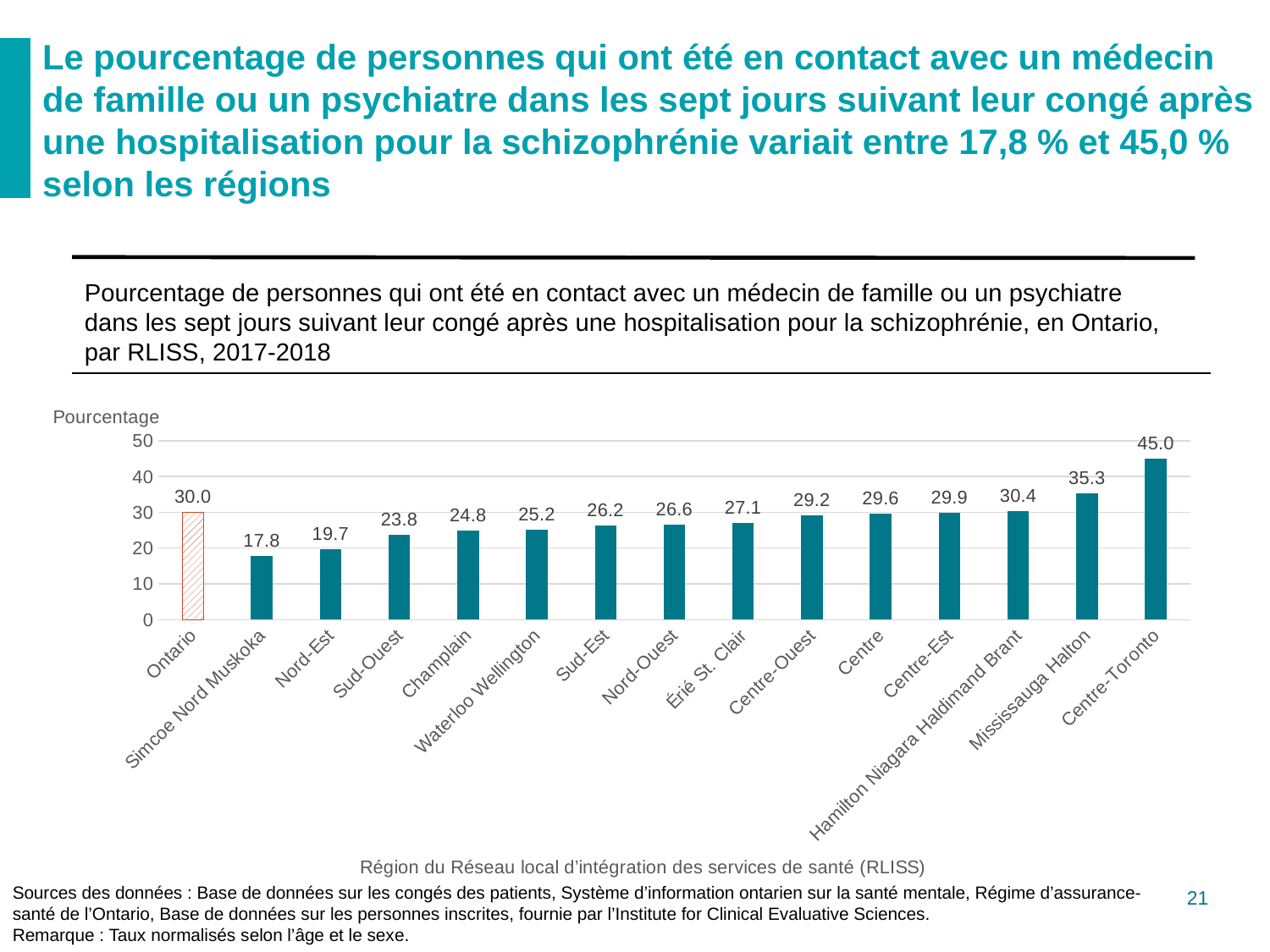
What is the difference between the values for Centre-Toronto and Simcoe Nord Muskoka? 27.2 Which is larger, the value for Mississauga Halton or the value for Centre-Est? Mississauga Halton What kind of chart is shown on the slide? bar chart What is the value for Champlain? 24.8 What is the value for Ontario? 30.0 Which region has the highest value? Centre-Toronto Do the values rise or fall from left to right after the Ontario bar? rise What is the label of the x axis? Région du Réseau local d'intégration des services de santé (RLISS) Is the value for Nord-Est greater or less than 20? less What is the value for Centre-Toronto? 45.0 How many bars are shown in the chart? 15 Which region has the lowest value? Simcoe Nord Muskoka